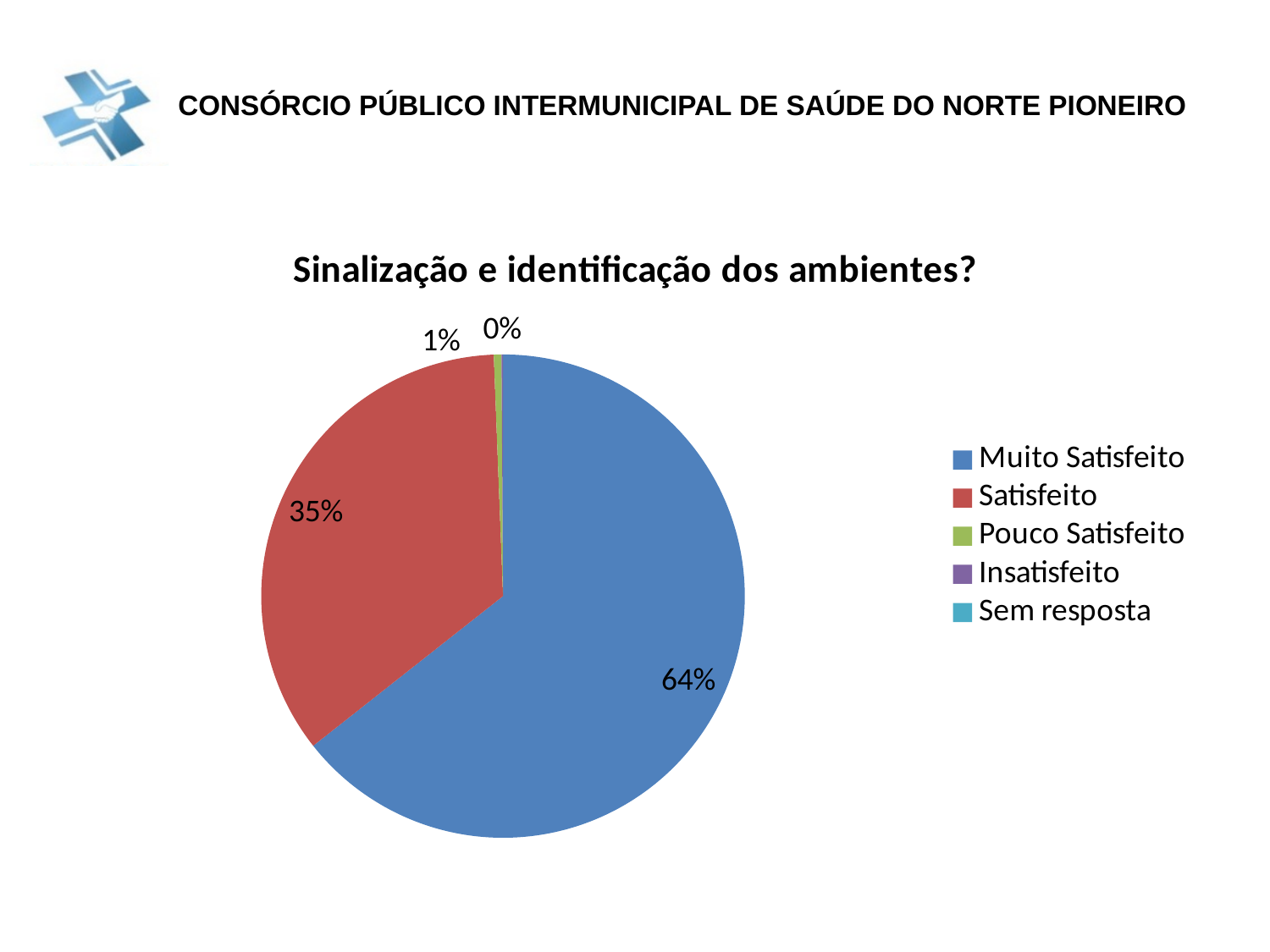
What percentage is shown for Pouco Satisfeito? 1% What share of the pie does Satisfeito represent? 35% How many categories does the legend list? 5 Which is larger, the Satisfeito slice or the Pouco Satisfeito slice? Satisfeito What is the difference in percentage points between Muito Satisfeito and Satisfeito? 29 percentage points What share of the pie does Muito Satisfeito represent? 64% What colour is the Satisfeito slice? Red What is the combined share of Muito Satisfeito and Satisfeito? 99% Which category has the largest slice of the pie? Muito Satisfeito What is the title of the chart? Sinalização e identificação dos ambientes? What kind of chart is shown on the slide? Pie chart Is the share for Muito Satisfeito greater or less than 50%? greater